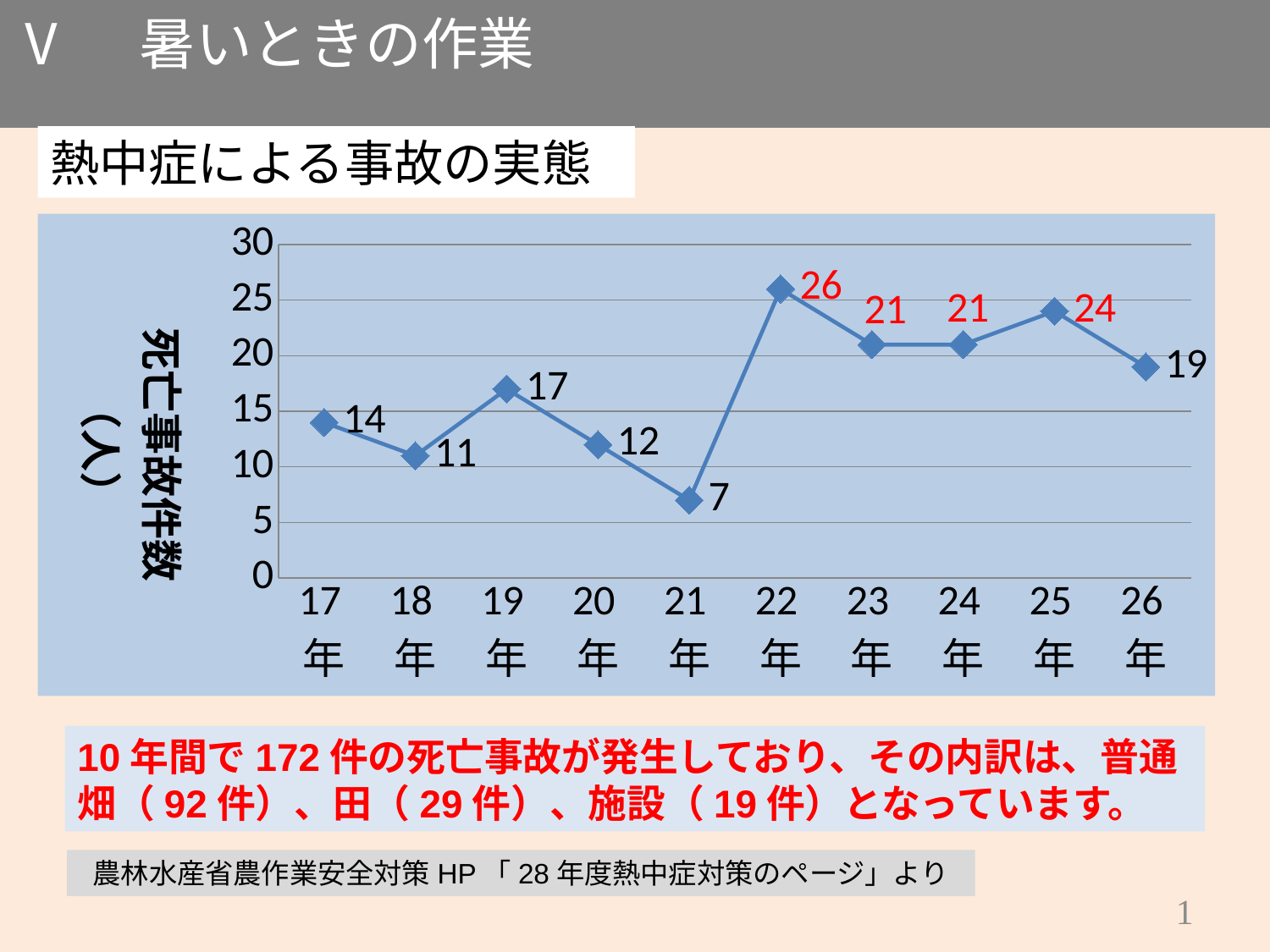
Which year has more fatal accidents, 19年 or 20年? 19年 What is the number of fatal accidents in 26年? 19 What kind of chart is shown on the slide? line chart Which year has the highest number of fatal accidents? 22年 What is the label of the vertical axis? 死亡事故件数（人） What is the number of fatal accidents (死亡事故件数) in 22年? 26 What is the number of fatal accidents in 17年? 14 How many years are plotted on the x axis? 10 What is the number of fatal accidents in 21年? 7 Which year has the lowest number of fatal accidents? 21年 Do the fatal accident numbers rise or fall from 21年 to 22年? rise What is the difference in fatal accidents between 22年 and 21年? 19